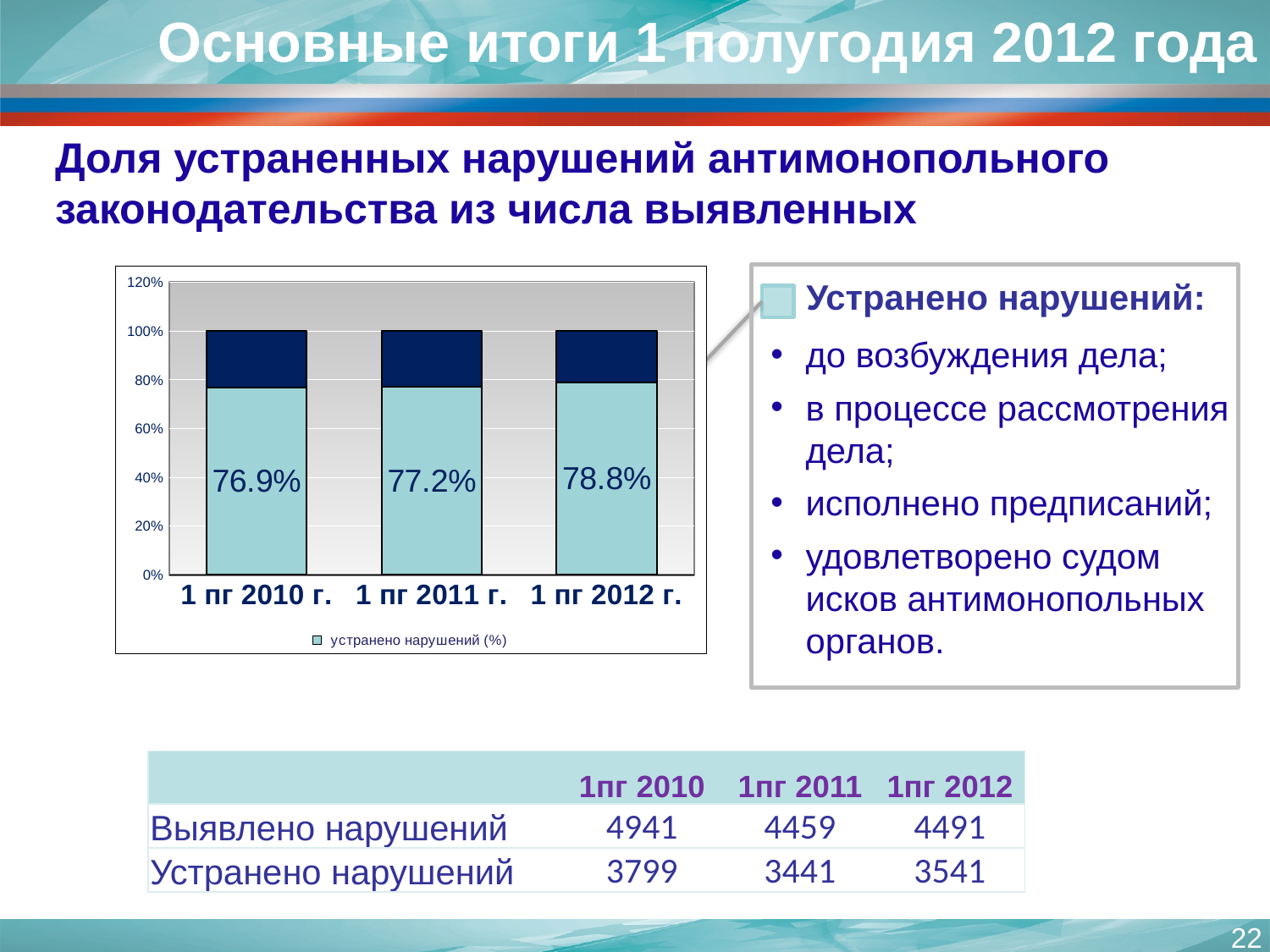
What is the value for 1 пг 2010 г. in the chart? 76.9% What is the value for 1 пг 2011 г. in the chart? 77.2% What is the difference between the values for 1 пг 2012 г. and 1 пг 2010 г.? 1.9 percentage points Do the labelled values rise or fall from 1 пг 2010 г. to 1 пг 2012 г.? rise How many series does the chart legend list? 1 Which period has the highest share of eliminated violations in the chart? 1 пг 2012 г. What is the value for 1 пг 2012 г. in the chart? 78.8% Is the value for 1 пг 2010 г. greater or less than 60%? greater How many periods are shown on the x axis of the chart? 3 What kind of chart is shown on the slide? bar chart Which period has the lowest share of eliminated violations in the chart? 1 пг 2010 г. Which is larger: the value for 1 пг 2011 г. or for 1 пг 2012 г.? 1 пг 2012 г.